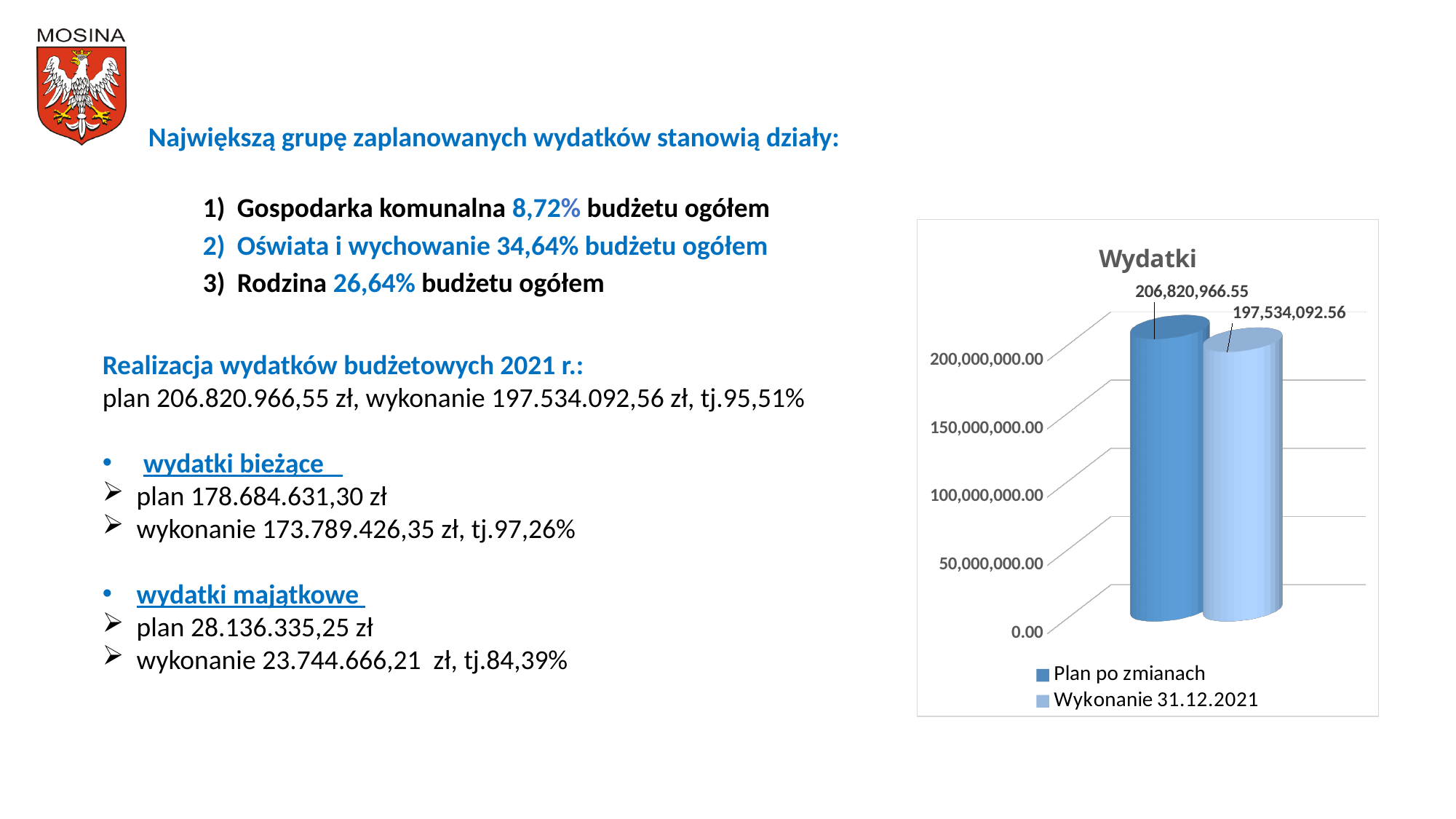
What is the value of the Plan po zmianach bar in the Wydatki chart? 206,820,966.55 What is the title of the chart on the slide? Wydatki What kind of chart is the Wydatki chart? bar chart In the Wydatki chart, is the value for Wykonanie 31.12.2021 greater or less than 200,000,000.00? less Which series has the higher value in the Wydatki chart? Plan po zmianach How many bars are plotted in the Wydatki chart? 2 What is the difference between the Plan po zmianach and Wykonanie 31.12.2021 values in the Wydatki chart? 9,286,873.99 Which series has the lower value in the Wydatki chart? Wykonanie 31.12.2021 In the Wydatki chart, is the value for Plan po zmianach larger or smaller than the value for Wykonanie 31.12.2021? larger How many series does the legend of the Wydatki chart list? 2 What is the value of the Wykonanie 31.12.2021 bar in the Wydatki chart? 197,534,092.56 In the Wydatki chart, is the value for Plan po zmianach greater or less than 200,000,000.00? greater